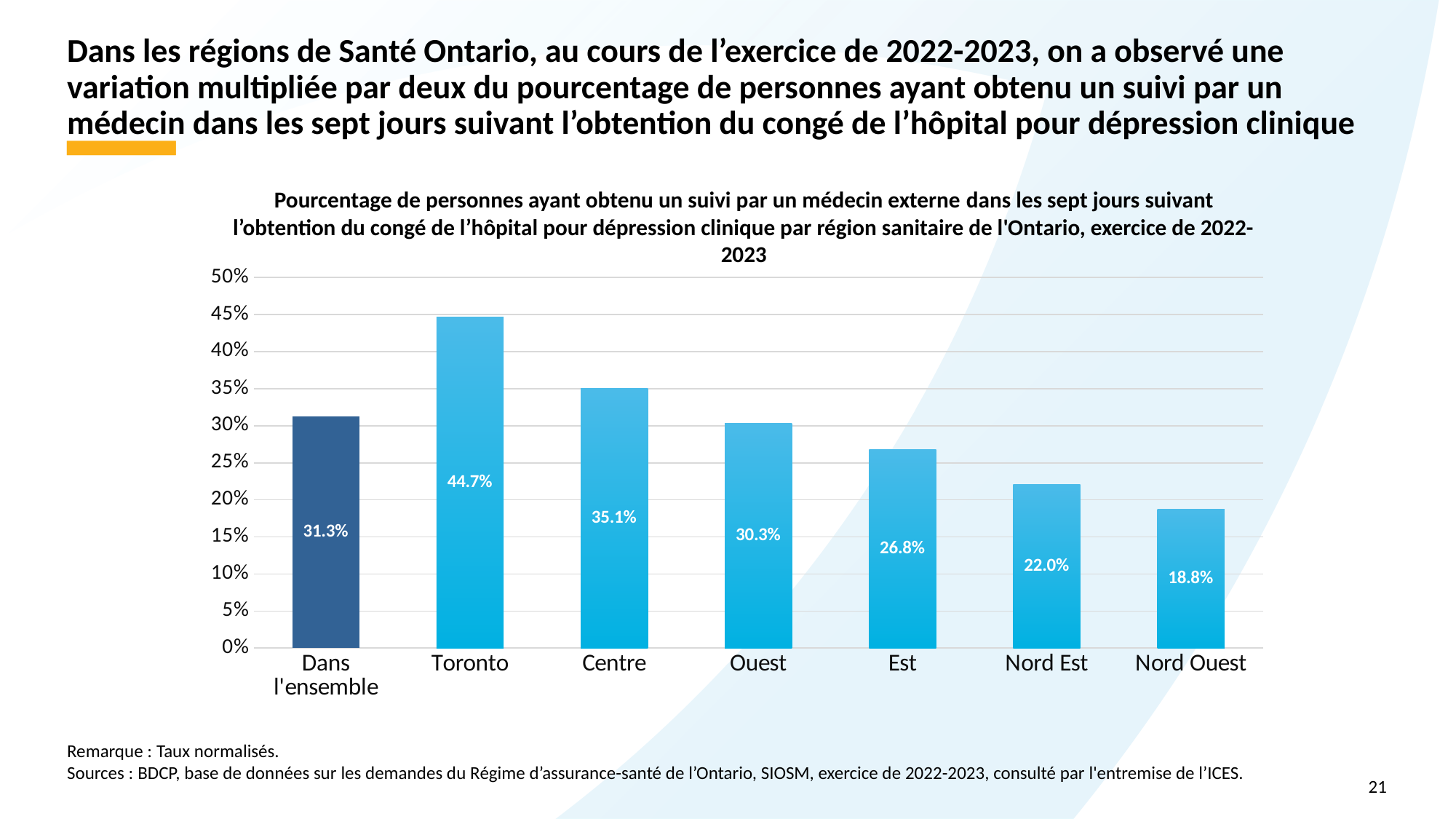
Which region has the highest percentage? Toronto Which is larger, the value for Est or the value for Nord Est? Est Which region has the lowest percentage? Nord Ouest What is the value for Dans l'ensemble? 31.3% What kind of chart is shown on the slide? Bar chart What is the value for Nord Ouest? 18.8% What is the value for Toronto? 44.7% What is the difference between the values for Centre and Ouest? 4.8% How many bars are shown in the chart? 7 What is the difference between the values for Toronto and Nord Ouest? 25.9% Is the value for Centre greater or less than 30%? greater Do the values rise or fall from Toronto to Nord Ouest along the x axis? Fall